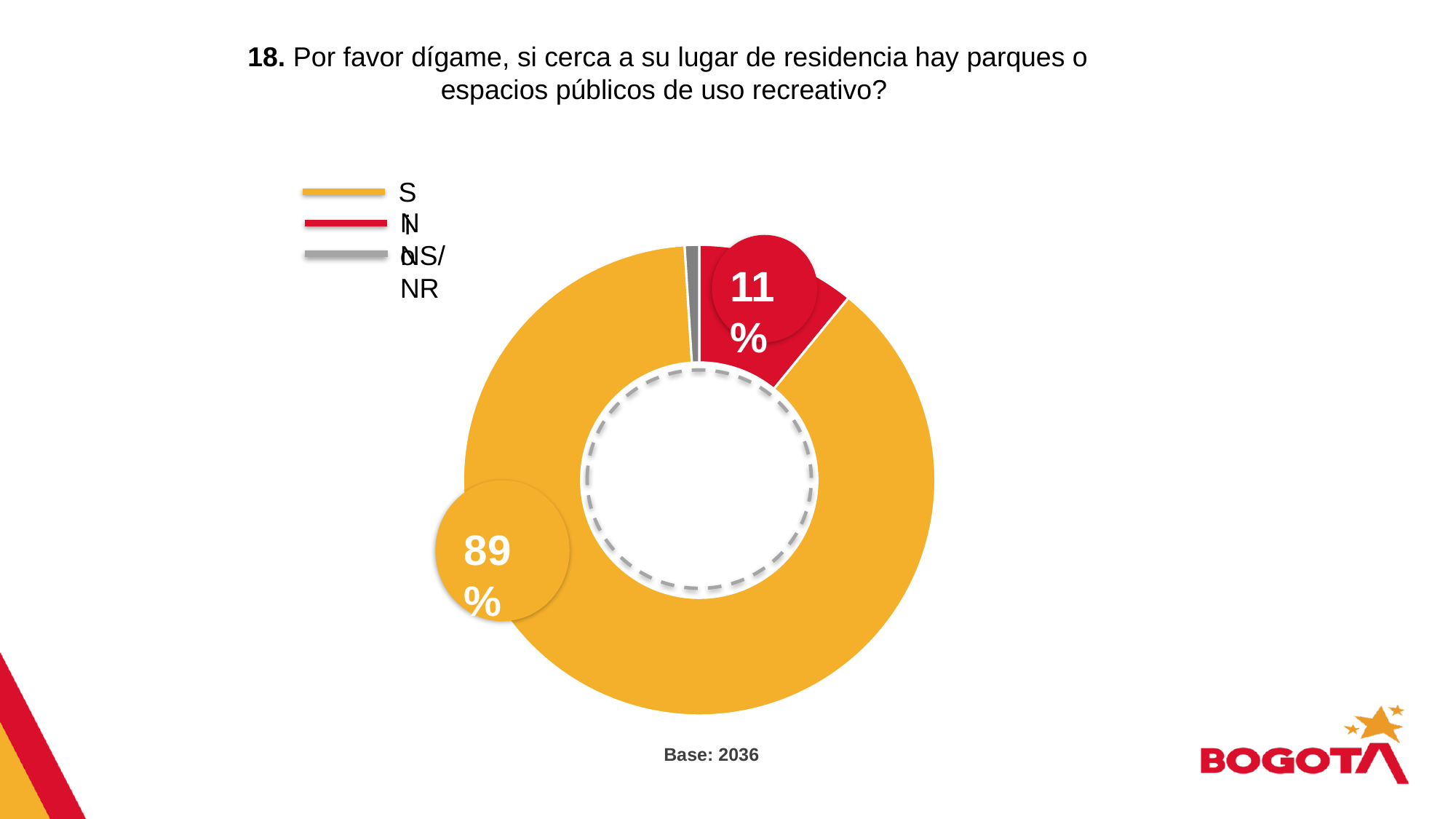
What kind of chart is shown on the slide? Pie chart (donut) Which is larger, the yellow slice or the red slice? The yellow slice Which slice of the pie chart is the largest? The yellow slice (89%) What is the difference in percentage points between the yellow slice and the red slice? 78 What percentage is shown on the yellow slice of the pie chart? 89% Which slice of the pie chart is the smallest? The grey NS/NR slice What percentage is shown on the red slice of the pie chart? 11% What is the base (number of respondents) shown below the chart? 2036 How many entries does the legend list? 3 What colour is the NS/NR entry in the legend? Grey How many slices does the pie chart have? 3